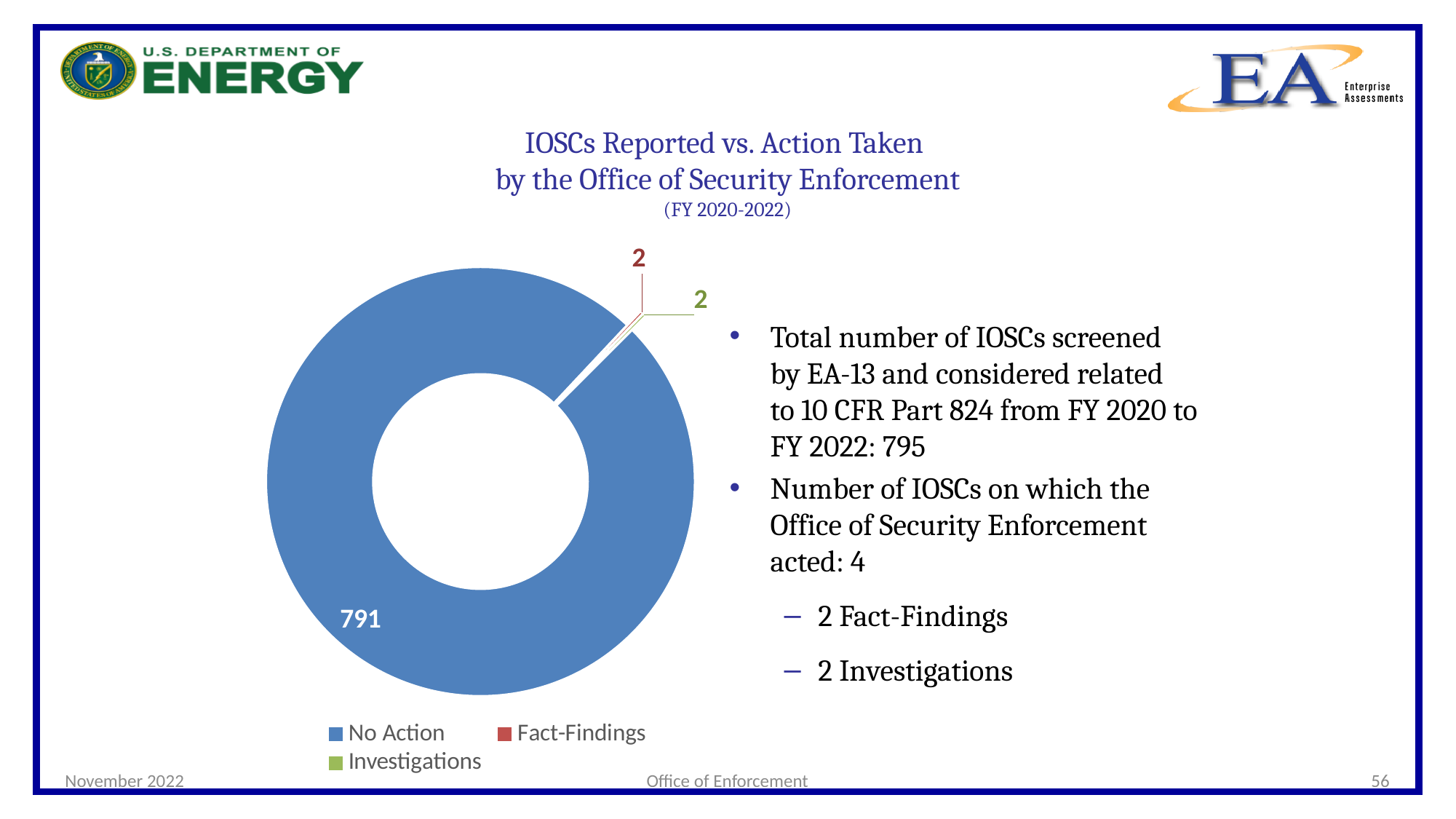
What is the total of all segments in the chart? 795 Which is larger, the No Action value or the Investigations value? No Action What value is shown for the Fact-Findings segment of the chart? 2 What value is shown for the No Action segment of the chart? 791 How many categories does the chart show? 3 What colour is the No Action segment in the chart? Blue How many entries does the chart legend list? 3 What is the title of the chart? IOSCs Reported vs. Action Taken by the Office of Security Enforcement (FY 2020-2022) What is the difference between the No Action value and the Fact-Findings value? 789 What value is shown for the Investigations segment of the chart? 2 What kind of chart is shown on the slide? Doughnut chart Which category has the largest segment in the chart? No Action